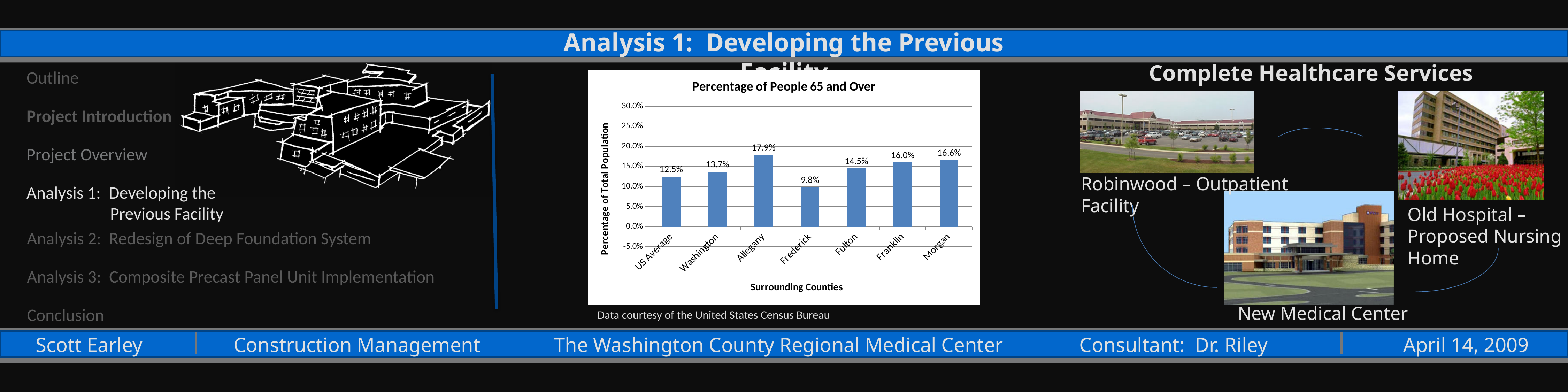
What is the value for the US Average in the chart? 12.5% Which category has the highest percentage of people 65 and over? Allegany What kind of chart is shown on the slide? bar chart What is the value for Allegany in the chart? 17.9% How many categories are shown on the x axis of the chart? 7 Is the value for Morgan greater or less than 15.0%? greater Which category has the lowest percentage of people 65 and over? Frederick What is the difference between the values for Allegany and Frederick? 8.1% What is the title of the chart? Percentage of People 65 and Over Which is larger, the value for Washington or the value for Fulton? Fulton What is the label of the x axis of the chart? Surrounding Counties What is the value for Frederick in the chart? 9.8%